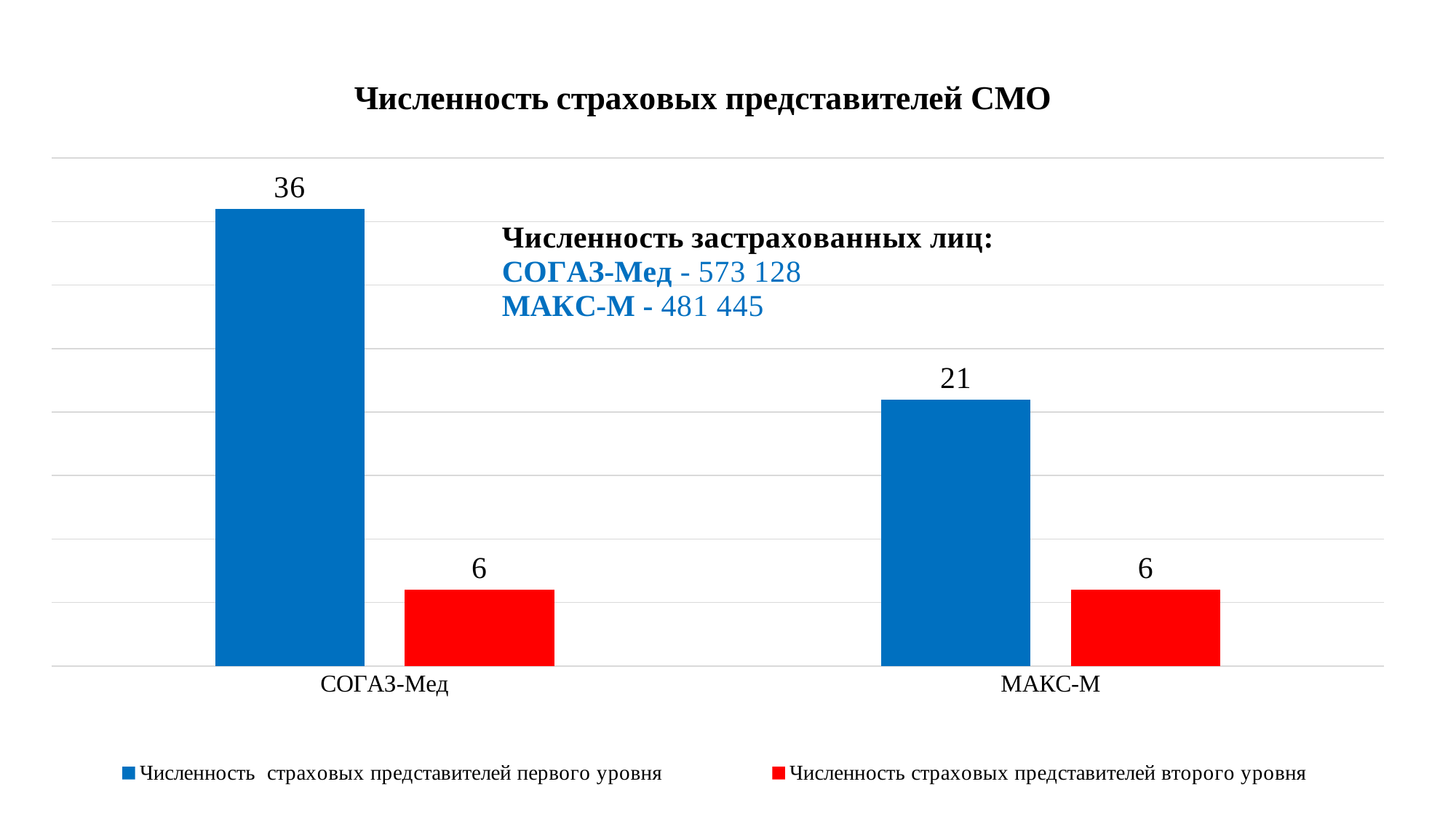
Which is larger: the first-level representatives for СОГАЗ-Мед or for МАКС-М? СОГАЗ-Мед How many series does the legend list? 2 What is the difference between the first-level and second-level representatives for МАКС-М? 15 What is the value of 'Численность страховых представителей первого уровня' for СОГАЗ-Мед? 36 How many categories are shown on the x axis? 2 What is the value of 'Численность страховых представителей второго уровня' for МАКС-М? 6 What is the value of 'Численность страховых представителей первого уровня' for МАКС-М? 21 What kind of chart is shown on the slide? Bar chart Which category has the highest value for 'Численность страховых представителей первого уровня'? СОГАЗ-Мед Which category has the lowest value for 'Численность страховых представителей первого уровня'? МАКС-М What is the value of 'Численность страховых представителей второго уровня' for СОГАЗ-Мед? 6 What is the difference between the first-level representatives for СОГАЗ-Мед and МАКС-М? 15